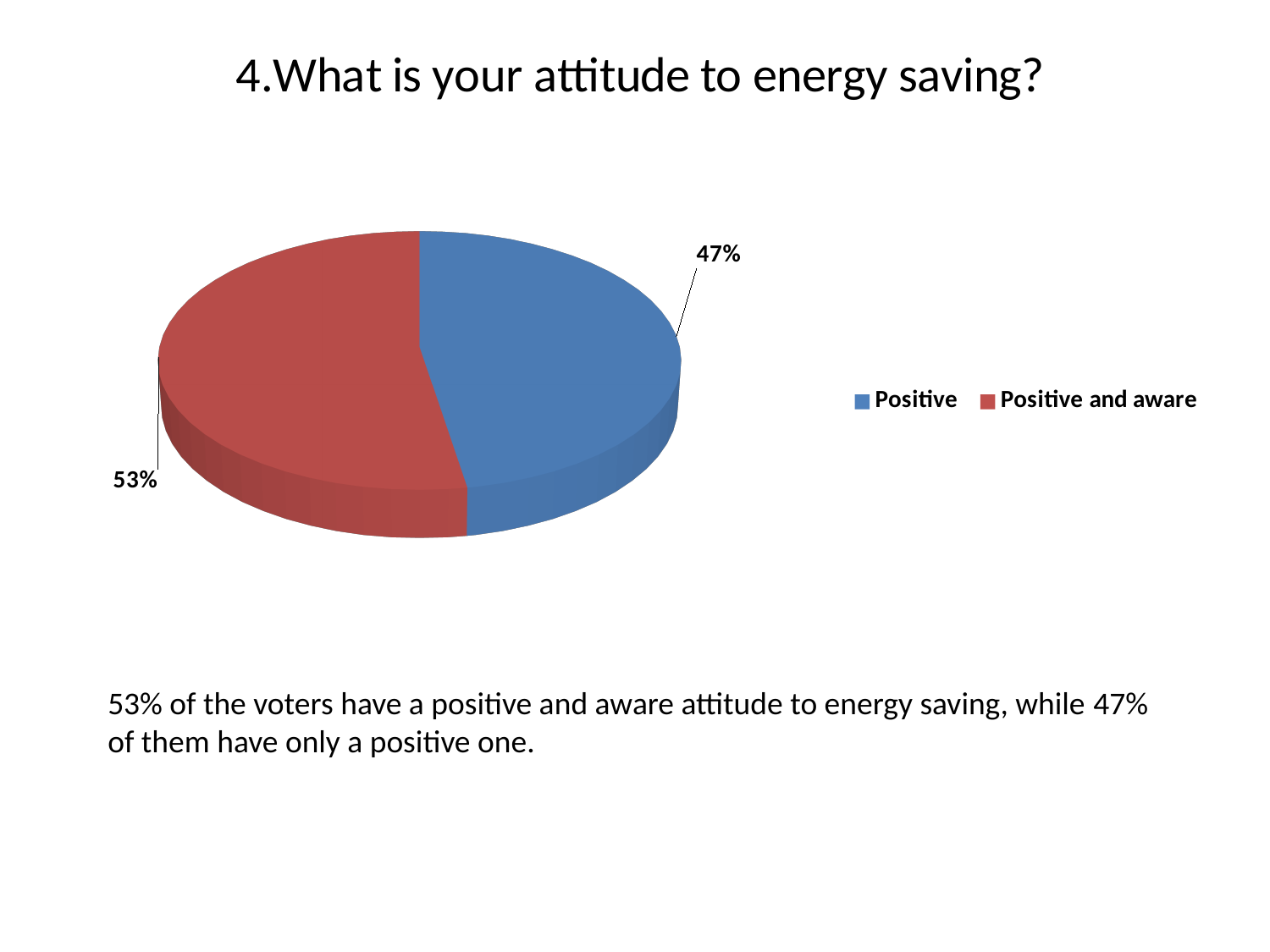
What share of the pie does the "Positive" slice represent? 47% Which slice is the smallest in the pie chart? Positive Which slice is the largest in the pie chart? Positive and aware What colour is the "Positive and aware" slice? red What colour is the "Positive" slice? blue What kind of chart is shown on the slide? pie chart What share of the pie does the "Positive and aware" slice represent? 53% How many entries does the legend list? 2 Which is larger, the "Positive" slice or the "Positive and aware" slice? Positive and aware How many slices does the pie chart have? 2 What is the difference in percentage points between the "Positive and aware" slice and the "Positive" slice? 6